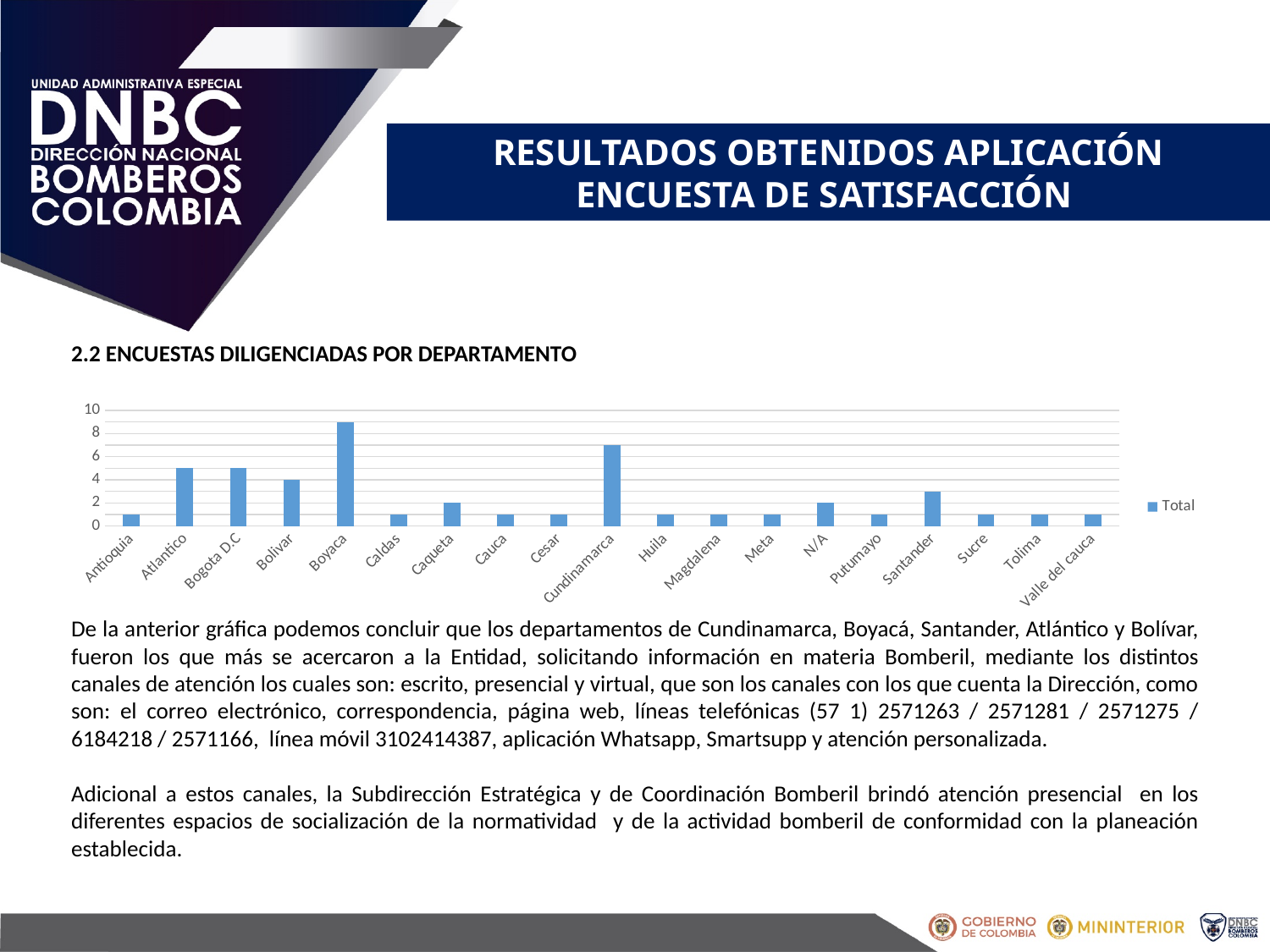
Is the value for Antioquia greater or less than 2? less What is the value for Bolivar in the chart? 4 Is the value for Santander greater or less than 4? less Which has a larger value, Cundinamarca or Santander? Cundinamarca What kind of chart is shown on the slide? bar chart Is the value for Cundinamarca greater or less than 6? greater How many series does the chart legend list? 1 Which department has the highest value in the chart? Boyaca What is the name of the series shown in the chart legend? Total How many categories are shown along the x axis of the chart? 19 Which has a larger value, Boyaca or Cundinamarca? Boyaca